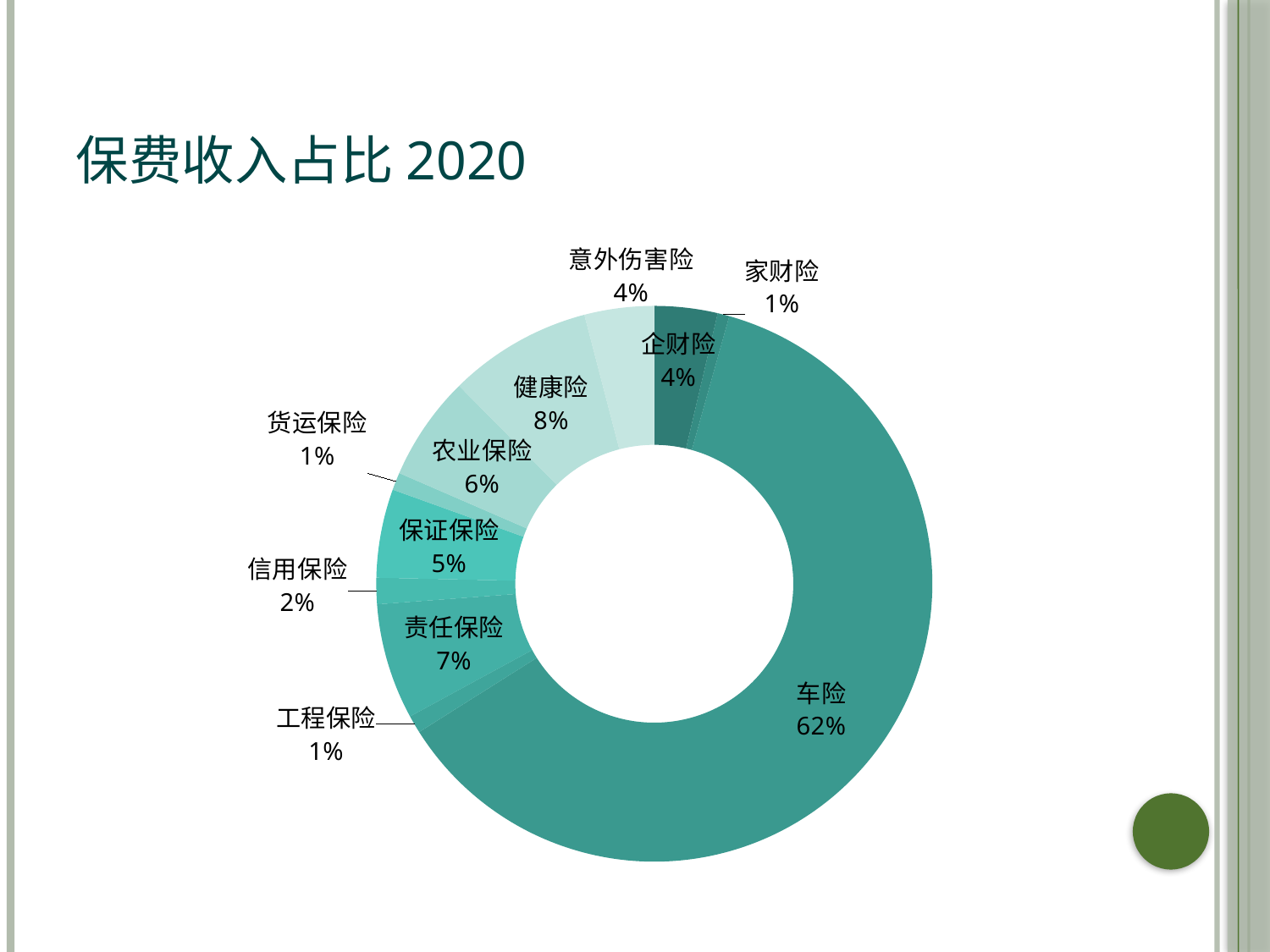
What is the value shown for 信用保险? 2% Which category has the largest share of the chart? 车险 What is the value shown for 健康险? 8% What kind of chart is shown on the slide? Doughnut (pie) chart What is the title of the slide? 保费收入占比 2020 What is the value shown for 农业保险? 6% What is the difference between the shares of 责任保险 and 保证保险? 2% What is the difference between the shares of 车险 and 健康险? 54% How many categories are shown in the chart? 11 Which has a larger share, 农业保险 or 企财险? 农业保险 What share of premium income does 车险 account for? 62% What is the value shown for 责任保险? 7%